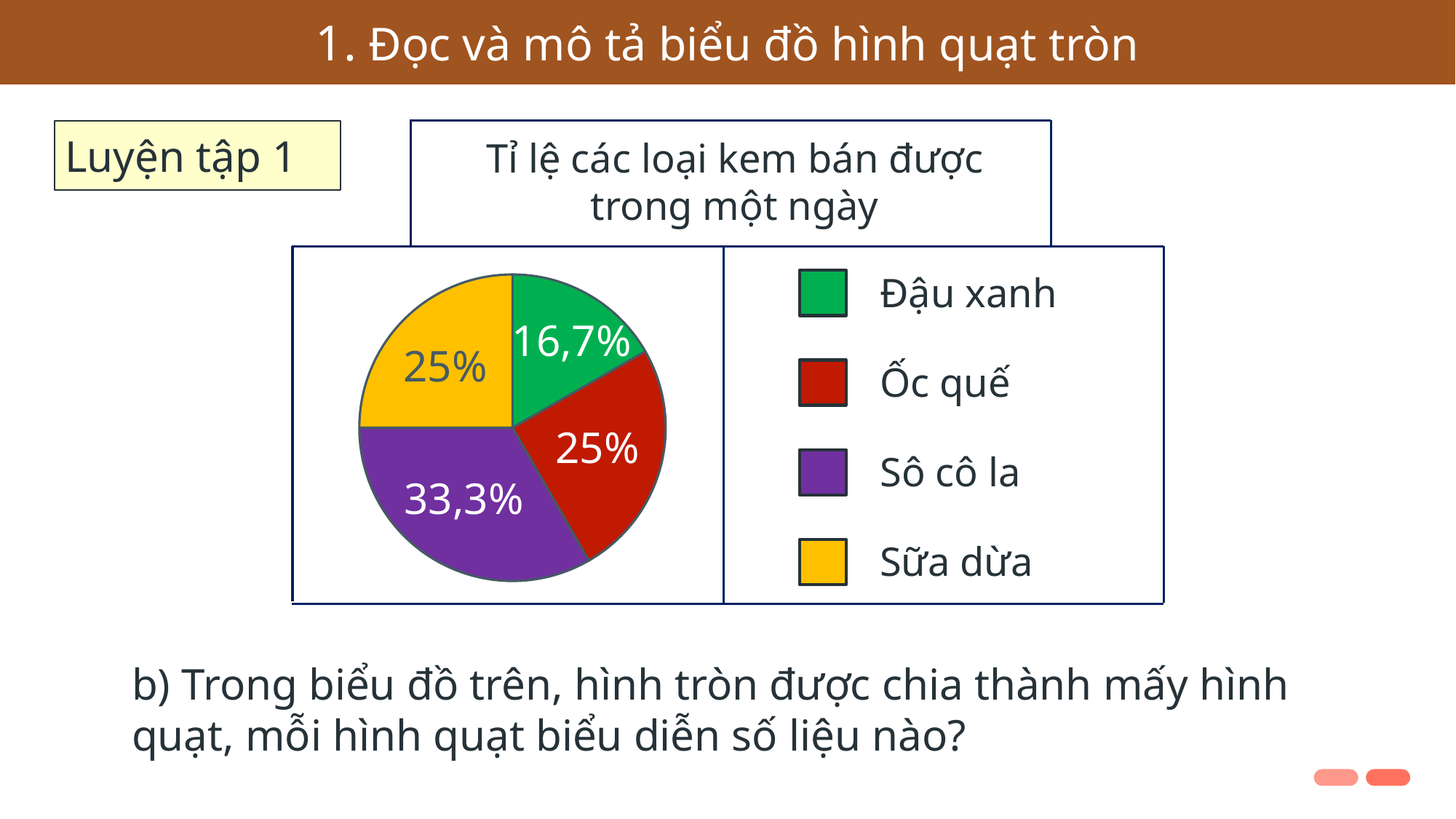
What colour is the Sữa dừa slice in the pie chart? yellow Which ice cream type has the smallest share of the pie? Đậu xanh Which two ice cream types have the same share of the pie? Ốc quế and Sữa dừa What percentage does the Sữa dừa slice show? 25% What percentage does the Đậu xanh slice show? 16,7% What kind of chart is shown on the slide? pie chart What percentage does the Ốc quế slice show? 25% What percentage does the Sô cô la slice show? 33,3% Which ice cream type has the largest share of the pie? Sô cô la What is the title of the pie chart? Tỉ lệ các loại kem bán được trong một ngày How many slices does the pie chart have? 4 Which is larger, the share for Sô cô la or the share for Đậu xanh? Sô cô la